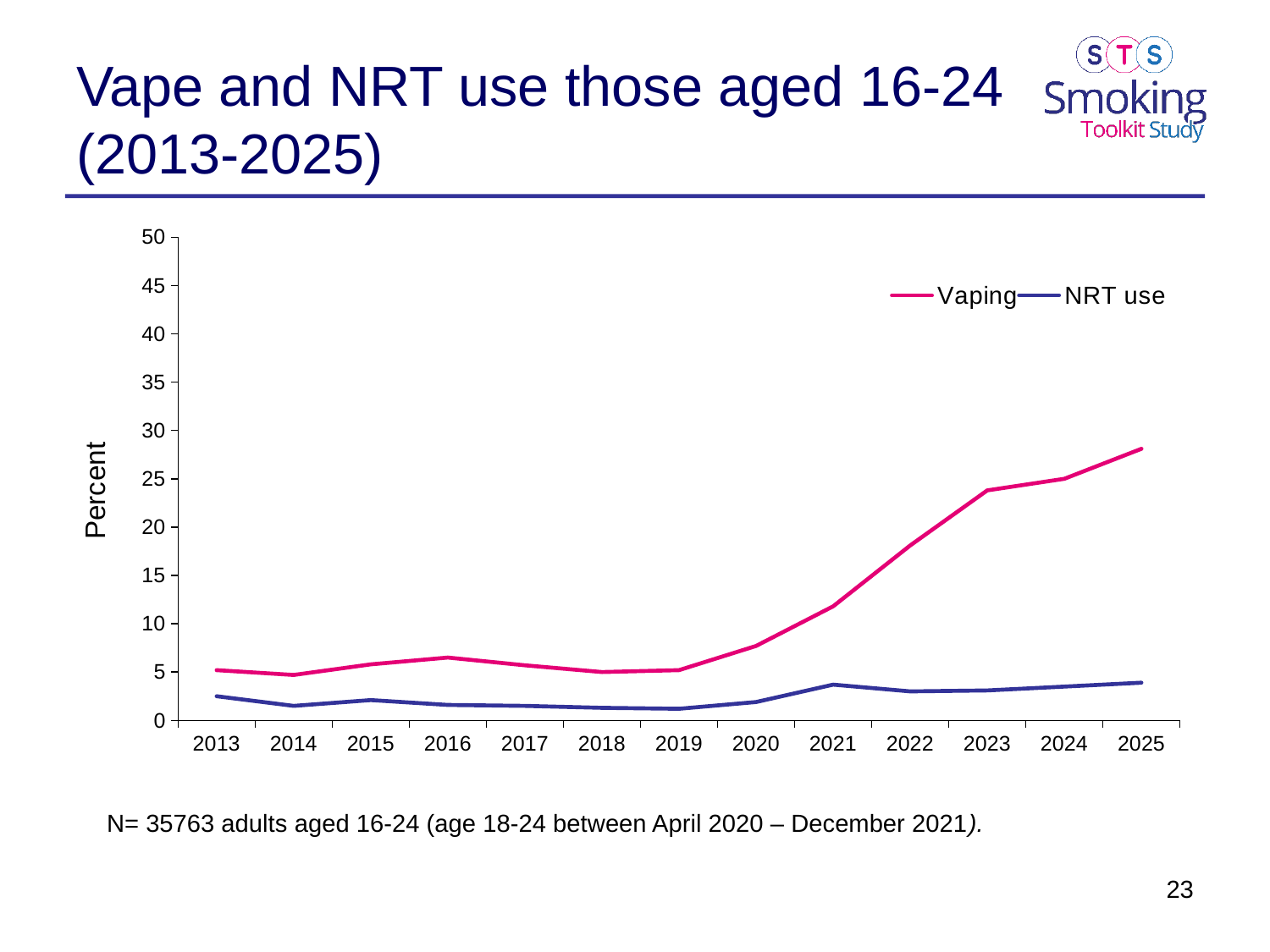
How many series does the legend list? 2 Which series is drawn in pink? Vaping What is the label on the y axis? Percent Does the Vaping series rise or fall between 2019 and 2025? Rise What kind of chart is shown on the slide? Line chart Is the value for NRT use in 2021 greater or less than 5? less In which year is the Vaping series at its highest? 2025 Is the value for Vaping in 2019 greater or less than 10? less Which series has the higher value in 2025, Vaping or NRT use? Vaping Is the value for Vaping in 2025 greater or less than 25? greater How many years are shown along the x axis? 13